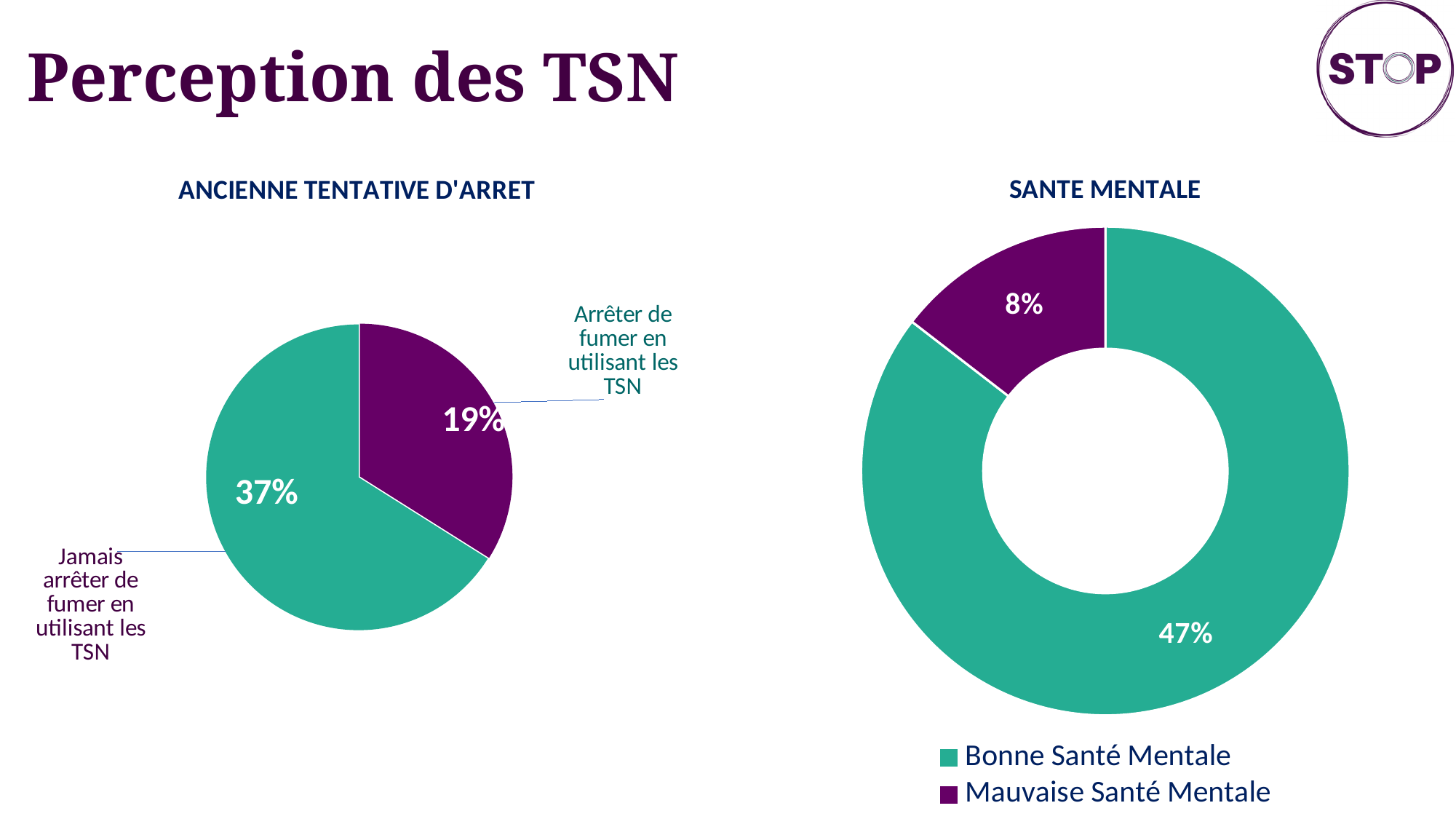
In the chart titled SANTE MENTALE, which category has the smallest slice? Mauvaise Santé Mentale In the chart titled ANCIENNE TENTATIVE D'ARRET, what value is shown for 'Jamais arrêter de fumer en utilisant les TSN'? 37% In the chart titled ANCIENNE TENTATIVE D'ARRET, what value is shown for 'Arrêter de fumer en utilisant les TSN'? 19% How many entries does the legend of the chart titled SANTE MENTALE list? 2 What kind of chart is the chart titled SANTE MENTALE? Doughnut chart In the chart titled SANTE MENTALE, which is larger: 'Bonne Santé Mentale' or 'Mauvaise Santé Mentale'? Bonne Santé Mentale How many slices does the chart titled ANCIENNE TENTATIVE D'ARRET have? 2 In the chart titled SANTE MENTALE, what value is shown for 'Mauvaise Santé Mentale'? 8% In the chart titled ANCIENNE TENTATIVE D'ARRET, which category has the largest slice? Jamais arrêter de fumer en utilisant les TSN In the chart titled ANCIENNE TENTATIVE D'ARRET, what is the difference between the two printed values? 18% In the chart titled SANTE MENTALE, what value is shown for 'Bonne Santé Mentale'? 47% In the chart titled SANTE MENTALE, what is the difference between the values for 'Bonne Santé Mentale' and 'Mauvaise Santé Mentale'? 39%